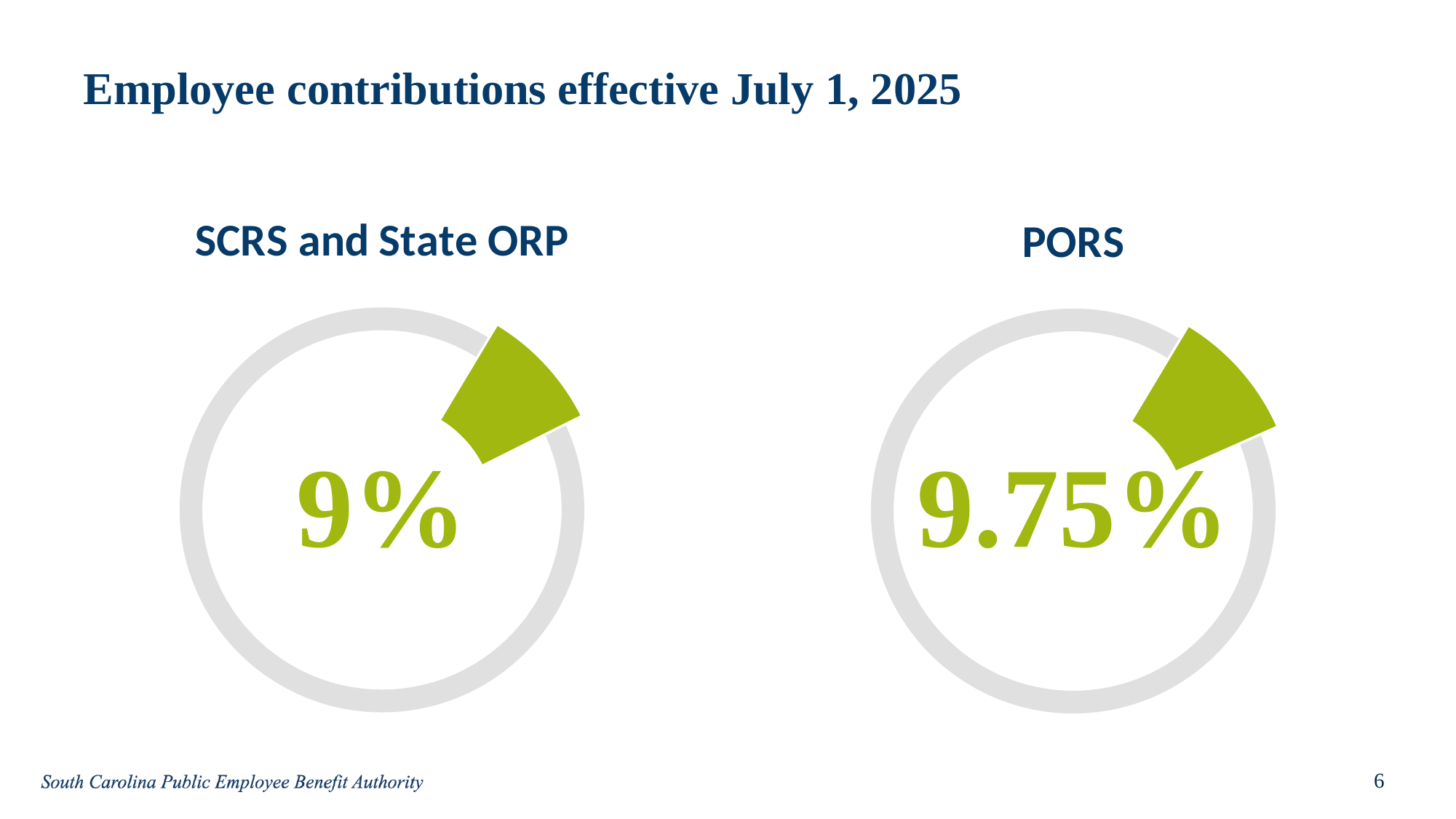
What is the title of the slide containing the two doughnut charts? Employee contributions effective July 1, 2025 How many doughnut charts are on the slide? 2 Which chart shows the lower contribution rate, "SCRS and State ORP" or "PORS"? SCRS and State ORP In the "PORS" chart, what colour is the highlighted slice representing the contribution rate? green In the "PORS" chart, what employee contribution rate is shown? 9.75% Which chart shows the higher contribution rate, "SCRS and State ORP" or "PORS"? PORS In the "SCRS and State ORP" chart, what employee contribution rate is shown? 9% What is the difference between the PORS rate and the SCRS and State ORP rate? 0.75% What kind of chart is shown under "SCRS and State ORP"? doughnut chart